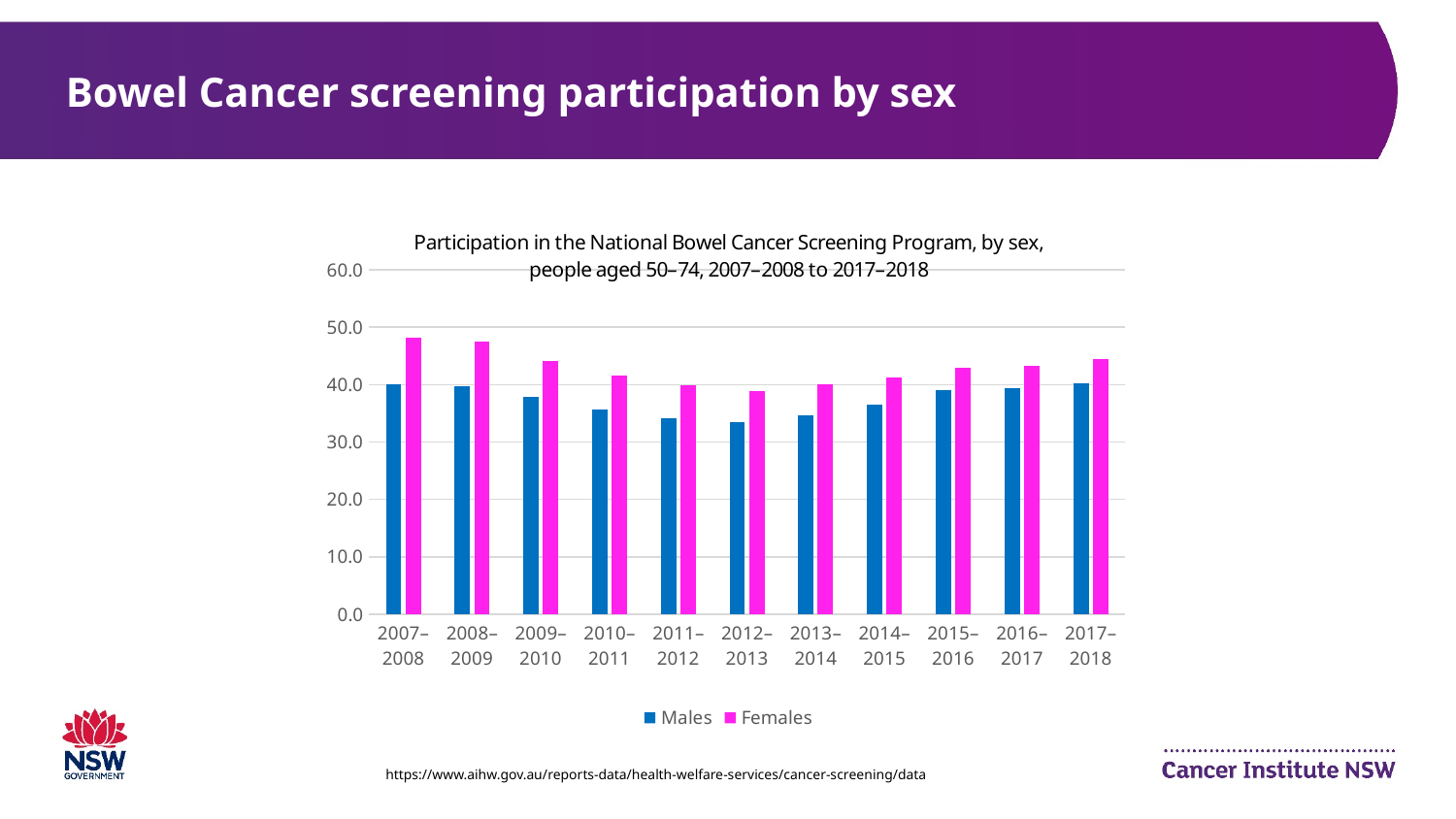
In 2007–2008, which is larger, the value for Males or the value for Females? Females How many series does the legend list? 2 For Males, which is larger, the value in 2007–2008 or the value in 2012–2013? 2007–2008 Is the value for Males in 2012–2013 greater or less than 40.0? less Is the value for Females in 2017–2018 greater or less than 50.0? less Is the value for Females in 2007–2008 greater or less than 40.0? greater How many time periods are shown on the x axis? 11 What kind of chart is shown on the slide? Bar chart Which colour represents Females in the chart? Magenta (pink) Do the Females values rise or fall from 2012–2013 to 2017–2018? rise Do the Males values rise or fall from 2007–2008 to 2012–2013? fall